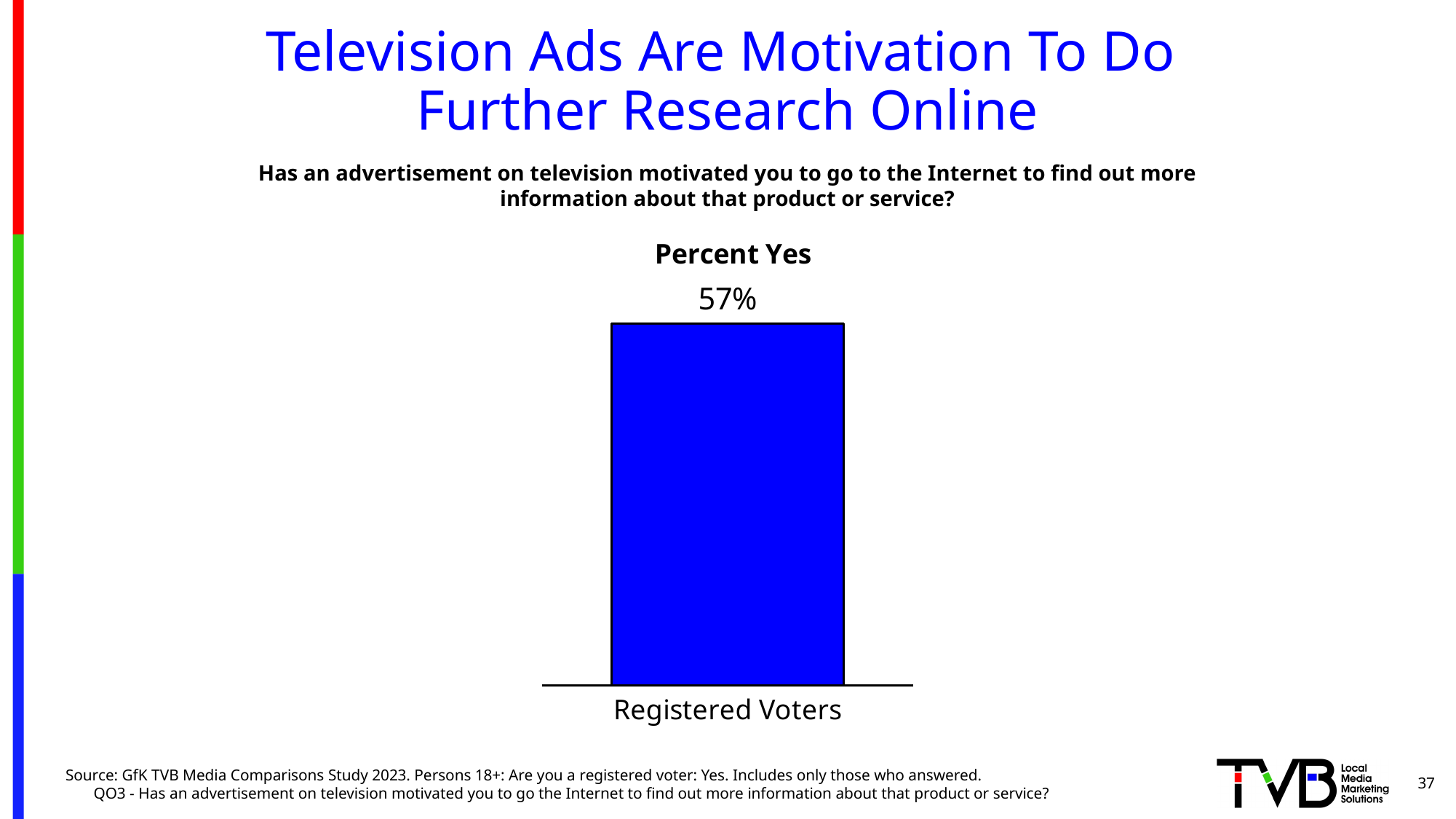
What is the value shown for Registered Voters? 57% What kind of chart is shown on the slide? bar chart Is the Percent Yes value for Registered Voters greater or less than 50%? greater What is the title of the chart? Percent Yes What is the category label on the x axis of the chart? Registered Voters How many bars does the chart show? 1